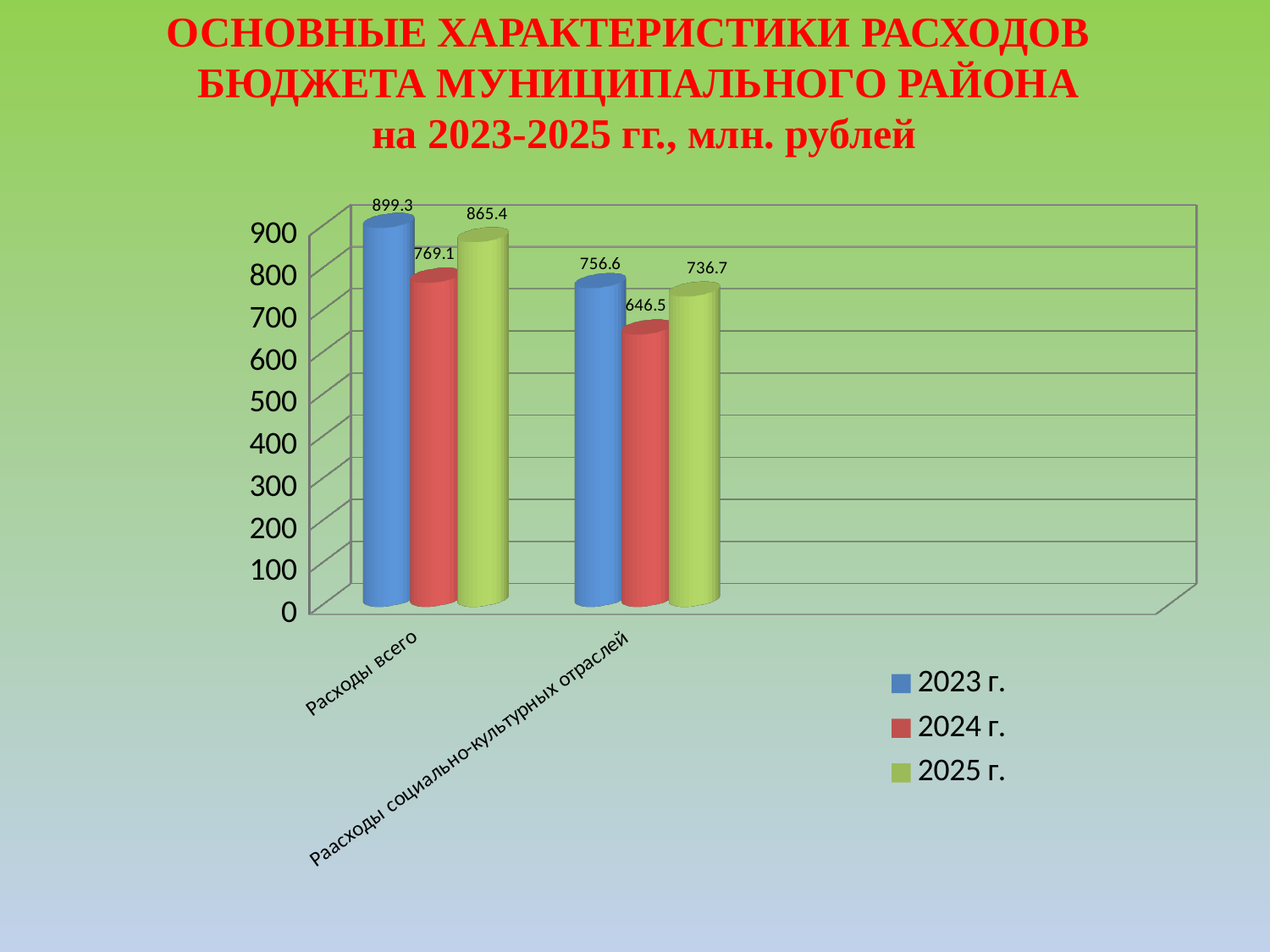
Which is larger: the 2025 г. value for Расходы всего or the 2023 г. value for Раасходы социально-культурных отраслей? 2025 г. value for Расходы всего How many categories are shown on the x axis? 2 What is the value for 2024 г. in the category Расходы всего? 769.1 What is the value for 2025 г. in the category Раасходы социально-культурных отраслей? 736.7 What is the difference between the 2023 г. and 2024 г. values in the category Расходы всего? 130.2 Is the value for 2024 г. in the category Раасходы социально-культурных отраслей greater or less than 700? less Which year has the highest value in the category Расходы всего? 2023 г. What is the value for 2024 г. in the category Раасходы социально-культурных отраслей? 646.5 What kind of chart is shown on the slide? bar chart Which year has the lowest value in the category Раасходы социально-культурных отраслей? 2024 г. What is the value for 2023 г. in the category Расходы всего? 899.3 How many series does the legend list? 3